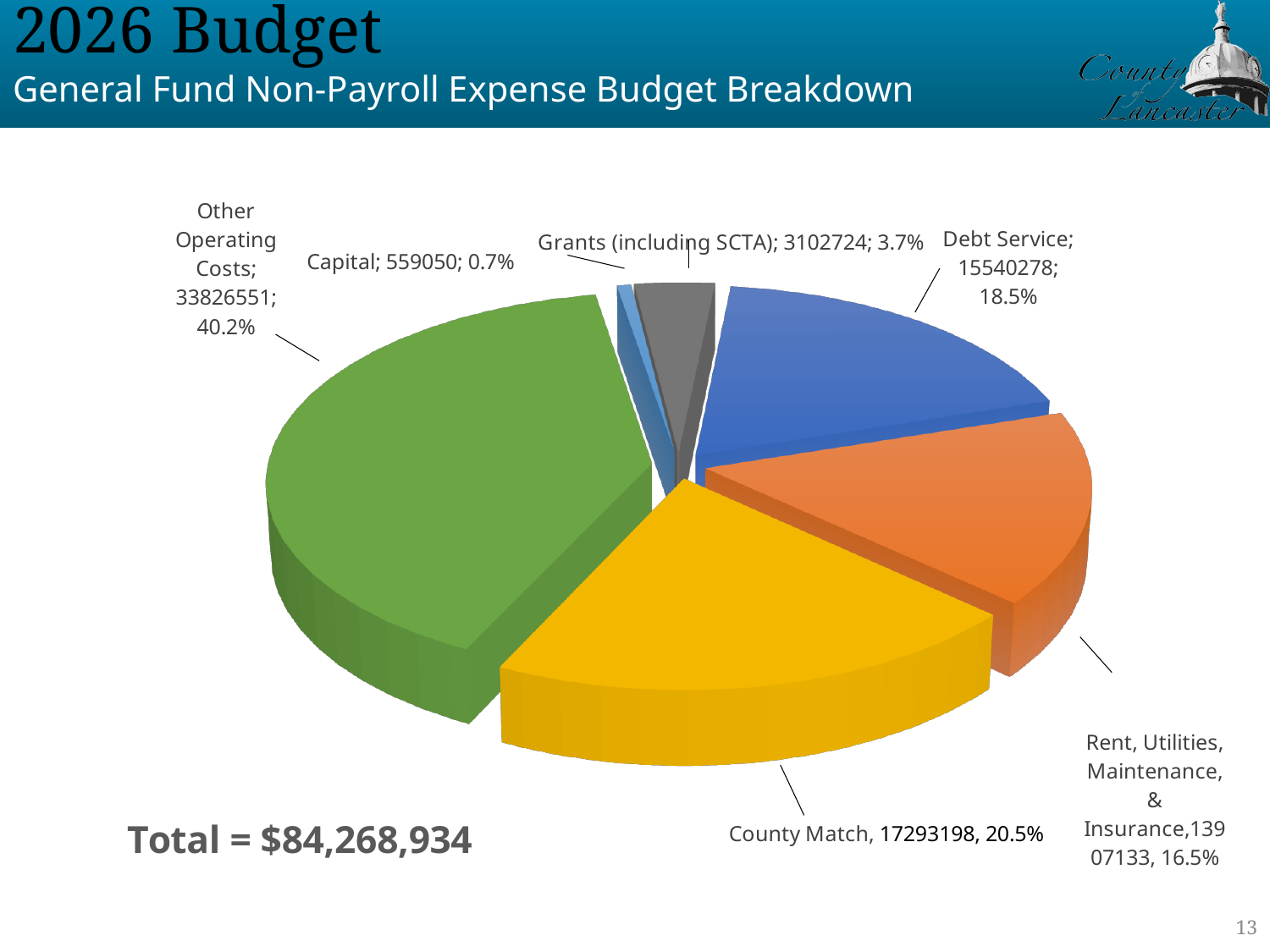
What is the value shown for County Match? 17293198 What kind of chart is shown on the slide? Pie chart What percentage share does Capital have? 0.7% What total is stated on the slide for the budget breakdown? $84,268,934 What percentage share does Other Operating Costs have? 40.2% What is the difference between the County Match value and the Debt Service value? 1752920 Which category has the smallest slice of the pie? Capital What is the value shown for Debt Service? 15540278 Which is larger, County Match or Debt Service? County Match How many slices does the pie chart have? 6 What percentage share does Grants (including SCTA) have? 3.7% Which category has the largest slice of the pie? Other Operating Costs